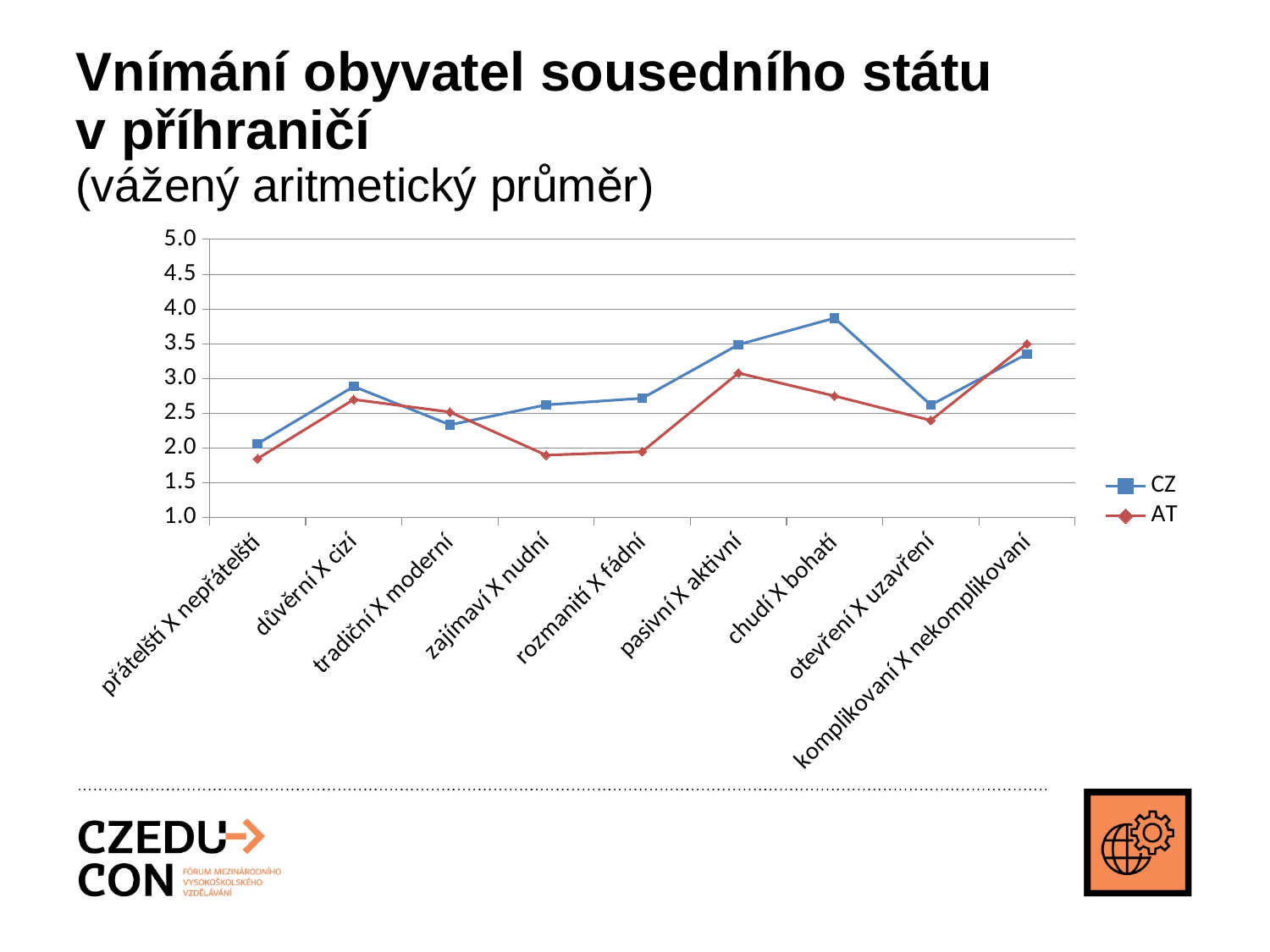
How many categories are plotted along the x axis? 9 How many series does the legend list? 2 Does the CZ line rise or fall from chudí X bohatí to otevření X uzavření? fall What kind of chart is shown on the slide? line chart For which category is the CZ value highest? chudí X bohatí For which category is the CZ value lowest? přátelští X nepřátelští For which category is the AT value highest? komplikovaní X nekomplikovaní Is the AT value for zajímaví X nudní greater or less than 2.5? less For chudí X bohatí, which series has the larger value, CZ or AT? CZ Is the AT value for chudí X bohatí greater or less than 3.0? less For tradiční X moderní, which series has the larger value, CZ or AT? AT Is the CZ value for chudí X bohatí greater or less than 3.5? greater